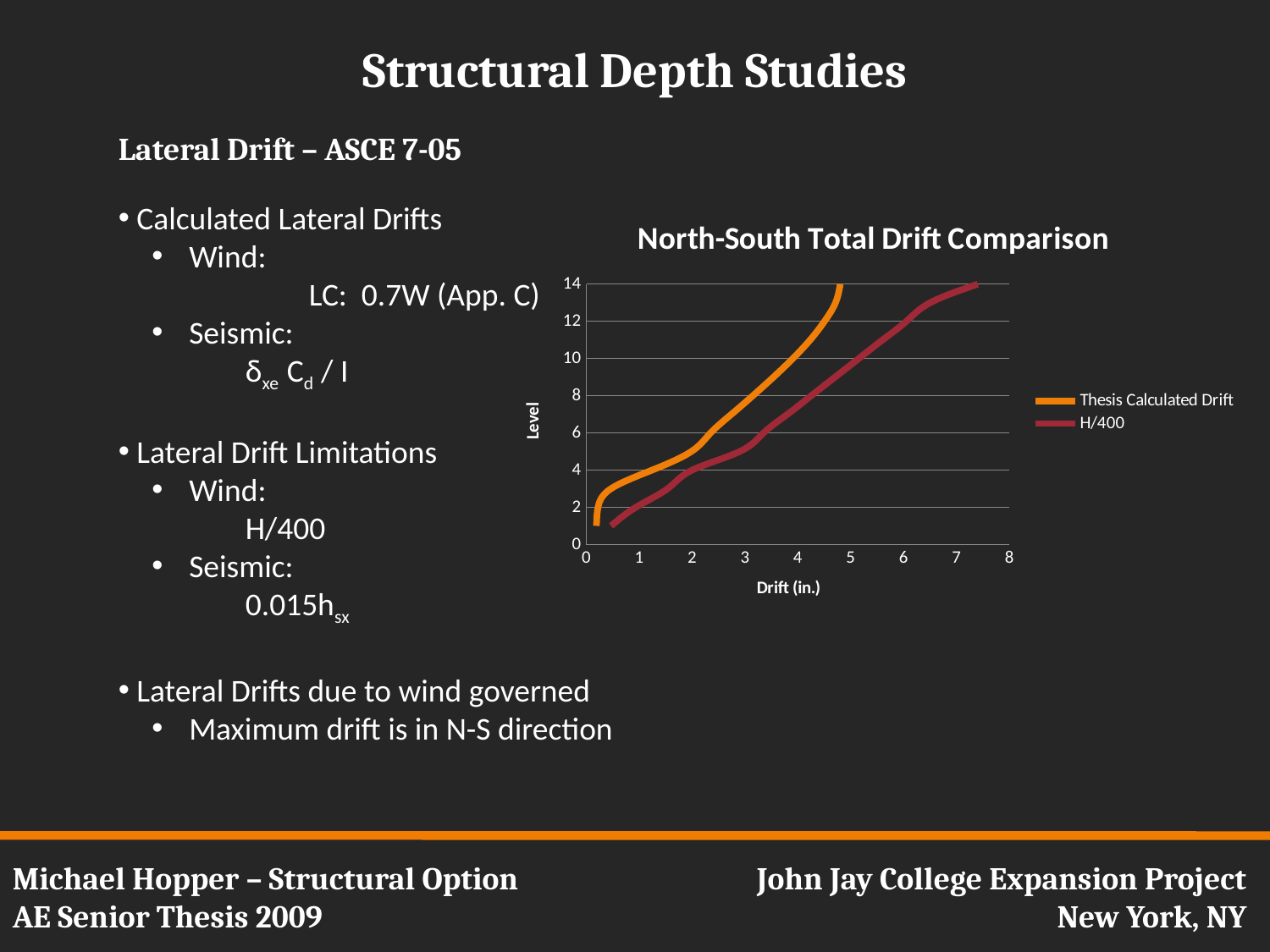
Which series has the smaller drift at Level 10, Thesis Calculated Drift or H/400? Thesis Calculated Drift How many series does the legend of the chart list? 2 Is the drift for the Thesis Calculated Drift series at Level 14 greater or less than 6? less Which series reaches a larger drift at Level 14, Thesis Calculated Drift or H/400? H/400 Is the drift for the Thesis Calculated Drift series at Level 6 greater or less than 3? less Is the drift for the H/400 series at Level 8 greater or less than 4? greater What is the title of the chart? North-South Total Drift Comparison Does the Level rise or fall as Drift increases along the x axis for the Thesis Calculated Drift series? rise What is the label of the horizontal axis of the chart? Drift (in.) What kind of chart is shown on the slide? line chart